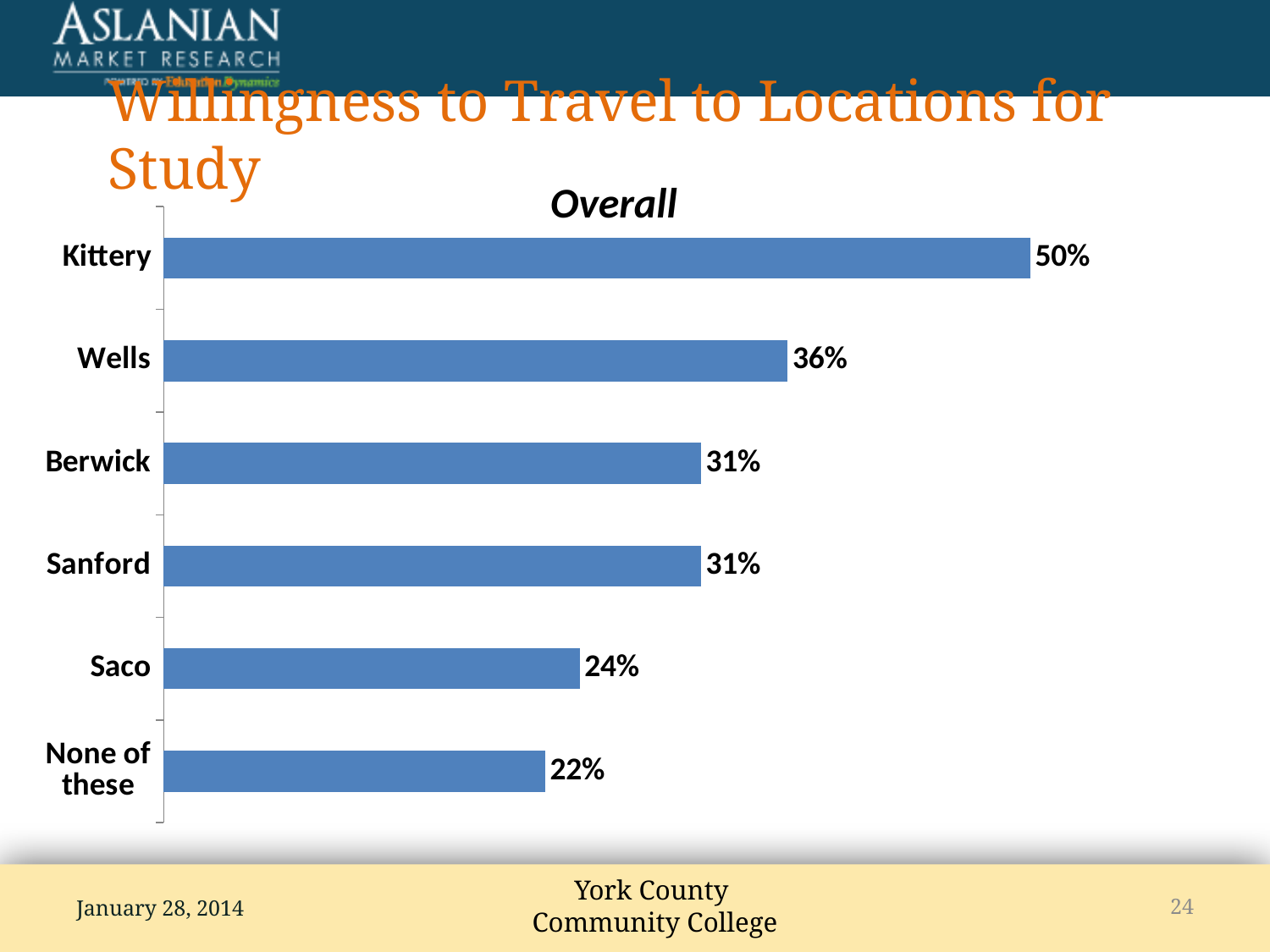
Which category has the lowest value? None of these What is the value for Saco? 24% What is the value for Wells? 36% What is the value for None of these? 22% Which location has the highest value? Kittery What is the difference between the values for Saco and None of these? 2% What is the difference between the values for Kittery and Wells? 14% How many categories are shown in the chart? 6 What is the title of the chart? Overall What kind of chart is shown on the slide? Bar chart Which is larger, the value for Wells or the value for Berwick? Wells What is the value for Kittery? 50%